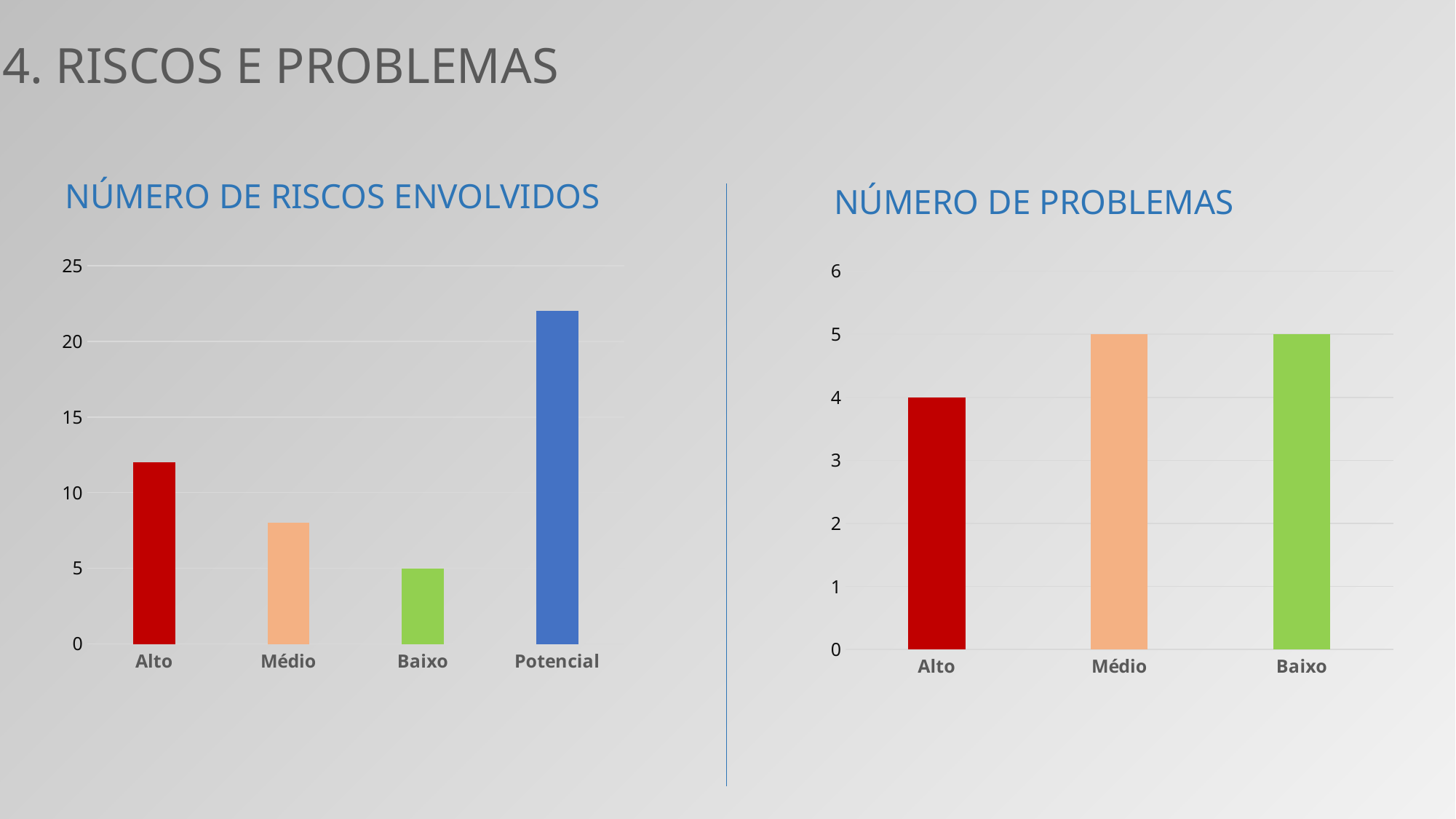
In the chart titled NÚMERO DE PROBLEMAS, what is the value for Médio? 5 In the chart titled NÚMERO DE RISCOS ENVOLVIDOS, is the value for Potencial greater or less than 20? greater In the chart titled NÚMERO DE RISCOS ENVOLVIDOS, is the value for Alto greater or less than 10? greater In the chart titled NÚMERO DE RISCOS ENVOLVIDOS, what is the value for Baixo? 5 In the chart titled NÚMERO DE RISCOS ENVOLVIDOS, which category has the lowest value? Baixo What kind of chart is the one titled NÚMERO DE PROBLEMAS? Bar chart In the chart titled NÚMERO DE RISCOS ENVOLVIDOS, which category has the highest value? Potencial In the chart titled NÚMERO DE PROBLEMAS, what is the difference between the values for Médio and Alto? 1 In the chart titled NÚMERO DE RISCOS ENVOLVIDOS, which is larger, the value for Alto or the value for Médio? Alto In the chart titled NÚMERO DE RISCOS ENVOLVIDOS, how many categories are shown on the x axis? 4 In the chart titled NÚMERO DE PROBLEMAS, which category has the lowest value? Alto In the chart titled NÚMERO DE PROBLEMAS, what is the value for Alto? 4